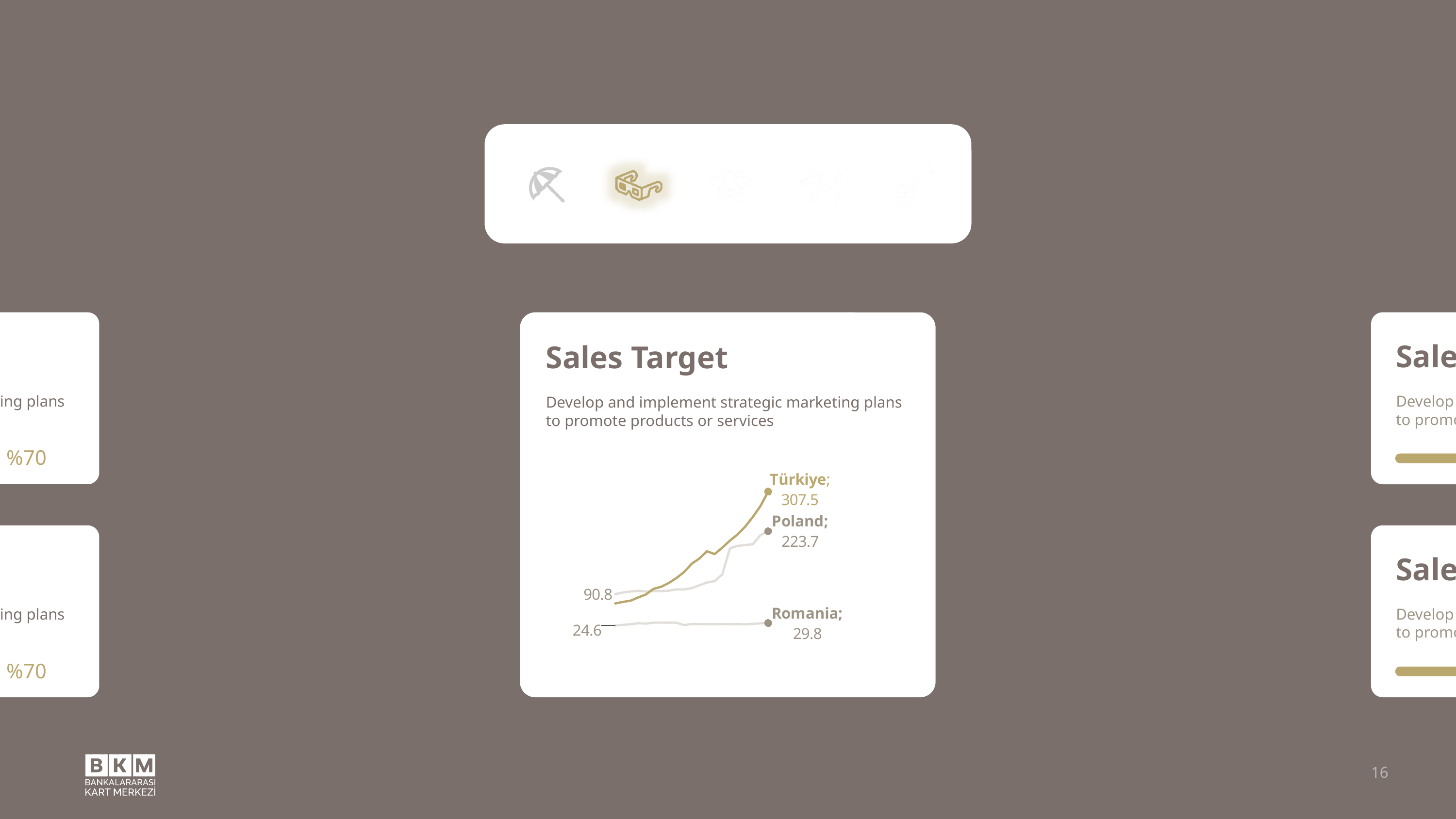
What is the title of the card containing the chart? Sales Target What is the final value shown for Romania? 29.8 What is the final value shown for Türkiye? 307.5 How many series (countries) are plotted in the chart? 3 Which has a larger final value, Poland or Romania? Poland Which country has the highest final value in the chart? Türkiye Which country has the lowest final value in the chart? Romania What kind of chart is shown on the Sales Target slide? line chart What is the difference between the final values of Poland and Romania? 193.9 What is the difference between the final values of Türkiye and Poland? 83.8 What is the final value shown for Poland? 223.7 Does the Türkiye line rise or fall from left to right? rise